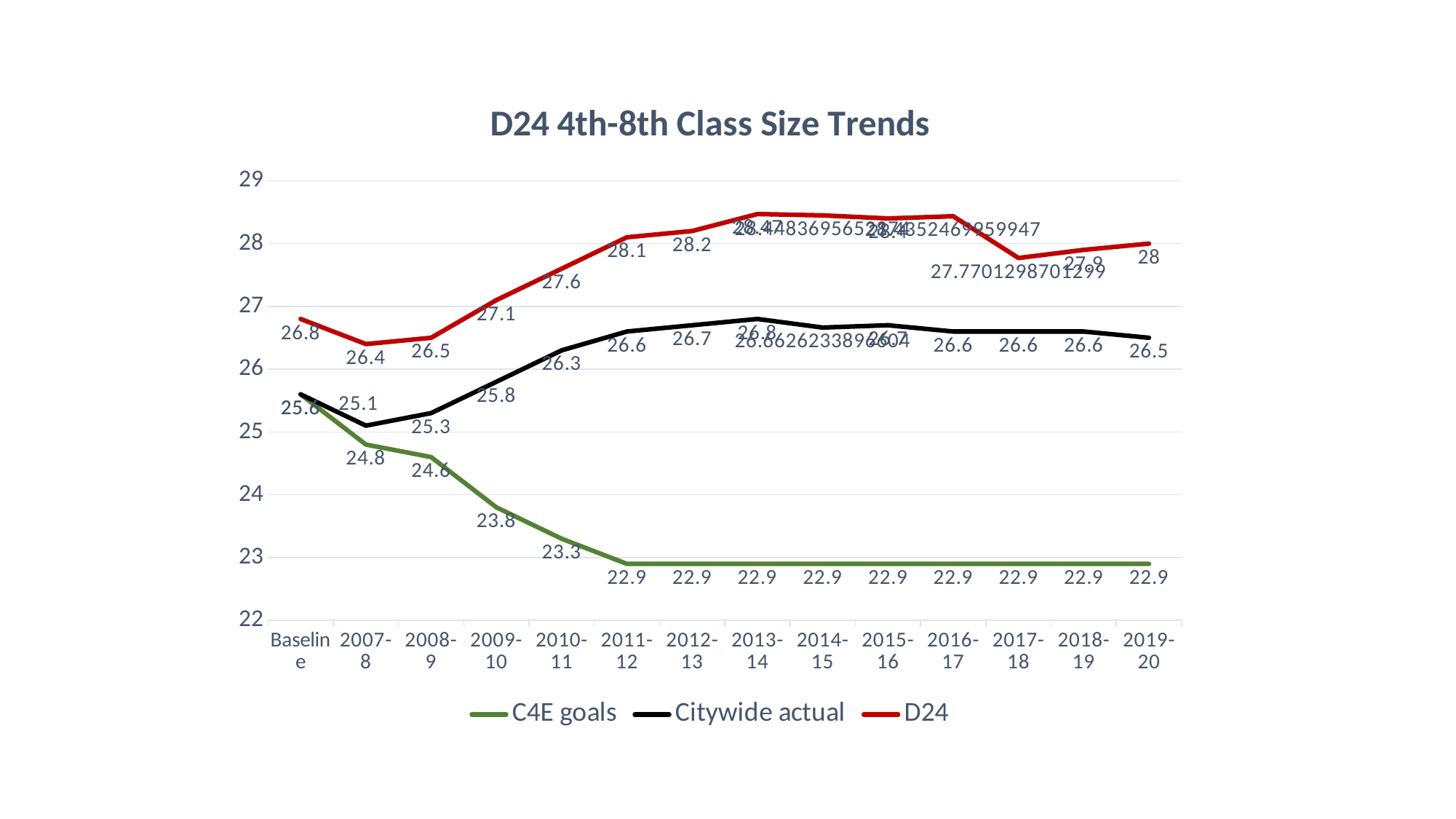
What is the C4E goals value for 2009-10? 23.8 What colour is the D24 line? red Do the C4E goals values rise or fall from Baseline to 2011-12? fall What is the D24 value for 2011-12? 28.1 How many categories are shown on the x axis? 14 In which year is the Citywide actual value lowest? 2007-8 What kind of chart is shown on the slide? line chart What is the Citywide actual value for 2019-20? 26.5 What is the difference between the D24 value and the Citywide actual value in 2019-20? 1.5 In which year is the D24 value lowest? 2007-8 How many series does the legend list? 3 In 2010-11, which is larger: the D24 value or the Citywide actual value? D24